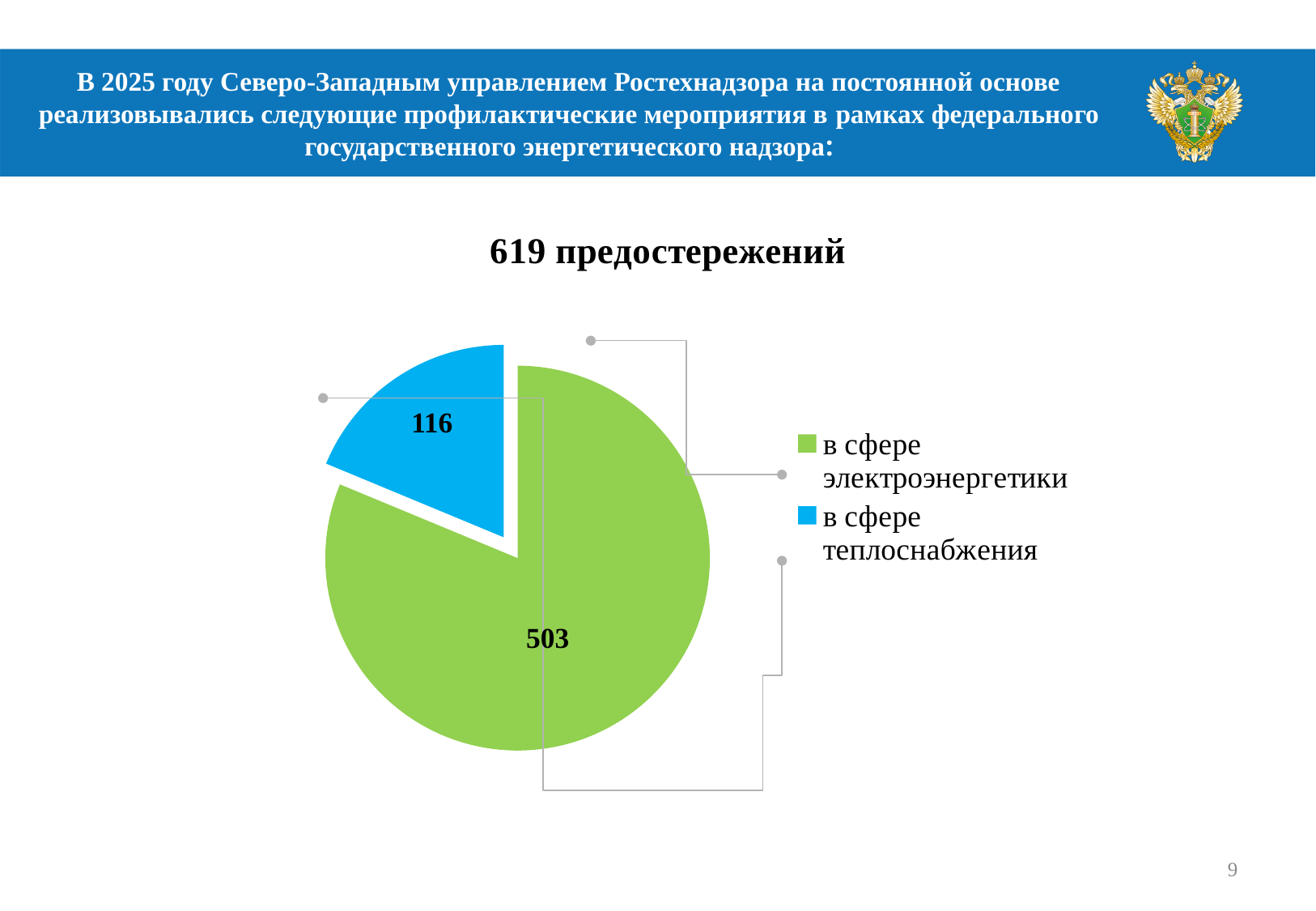
Which is larger: the value for electric power or the value for heat supply? в сфере электроэнергетики How many slices does the pie chart have? 2 How many warnings were issued in the sphere of heat supply (в сфере теплоснабжения)? 116 How many entries does the legend list? 2 What colour is the slice for electric power (в сфере электроэнергетики)? green What type of chart is shown on the slide? pie chart Which category has the largest slice of the pie? в сфере электроэнергетики Which category has the smallest slice of the pie? в сфере теплоснабжения How many warnings (предостережений) were issued in the sphere of electric power (в сфере электроэнергетики)? 503 What is the difference between the number of warnings in electric power and in heat supply? 387 What colour is the slice for heat supply (в сфере теплоснабжения)? blue What is the total number of warnings shown in the chart title? 619 предостережений